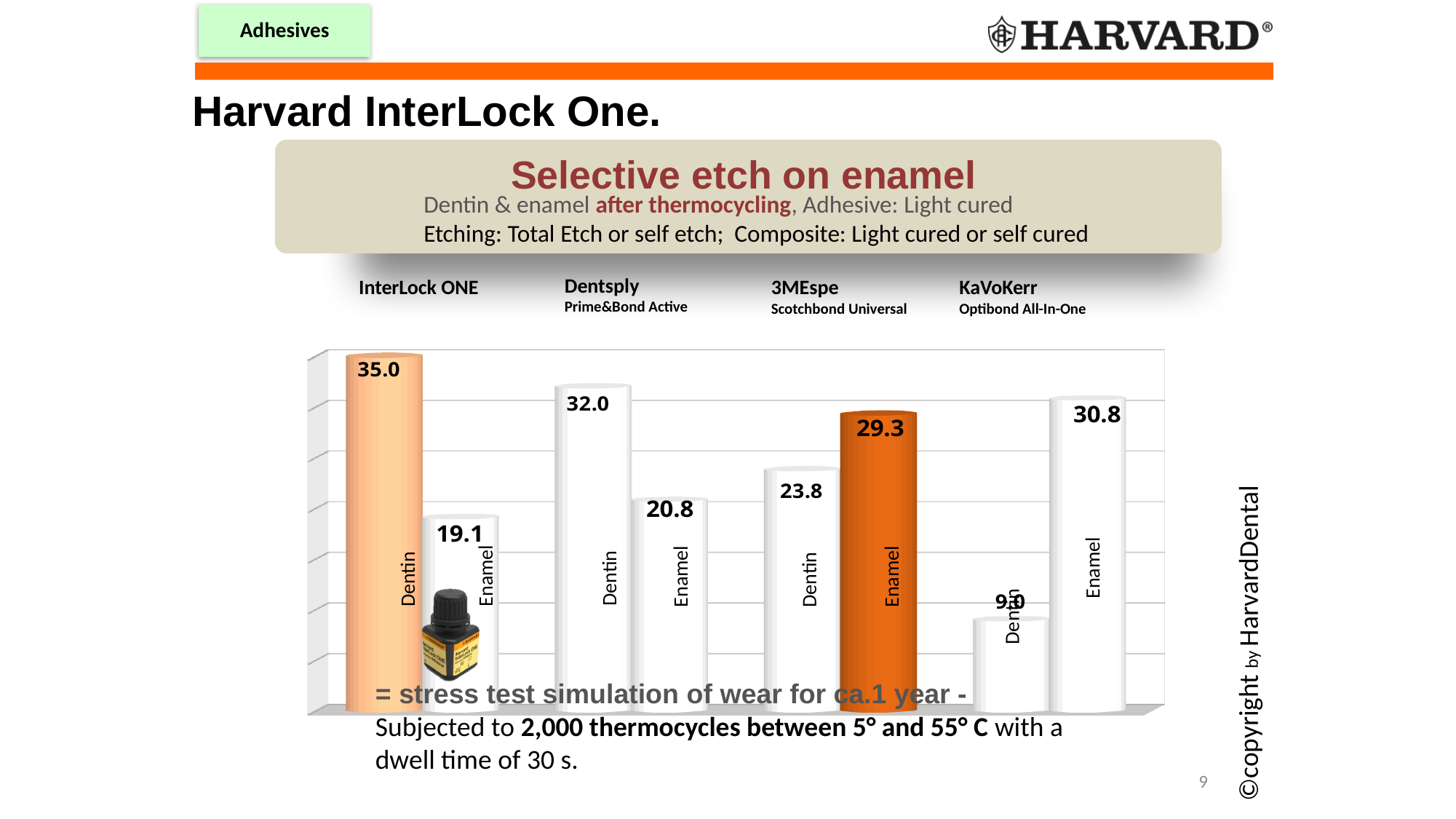
Which product has the lowest Dentin value? KaVoKerr Optibond All-In-One What is the difference between the Dentin and Enamel values for InterLock ONE? 15.9 What is the Enamel value for KaVoKerr Optibond All-In-One? 30.8 Which product has the highest Enamel value? KaVoKerr Optibond All-In-One Which product has the highest Dentin value? InterLock ONE How many bars are plotted in the chart? 8 Which is larger for 3MEspe Scotchbond Universal, the Dentin value or the Enamel value? Enamel What is the Dentin value for InterLock ONE? 35.0 What is the Enamel value for 3MEspe Scotchbond Universal? 29.3 What kind of chart is shown on the slide? Bar chart What is the difference between the Dentin values of InterLock ONE and Dentsply Prime&Bond Active? 3.0 What is the Enamel value for Dentsply Prime&Bond Active? 20.8